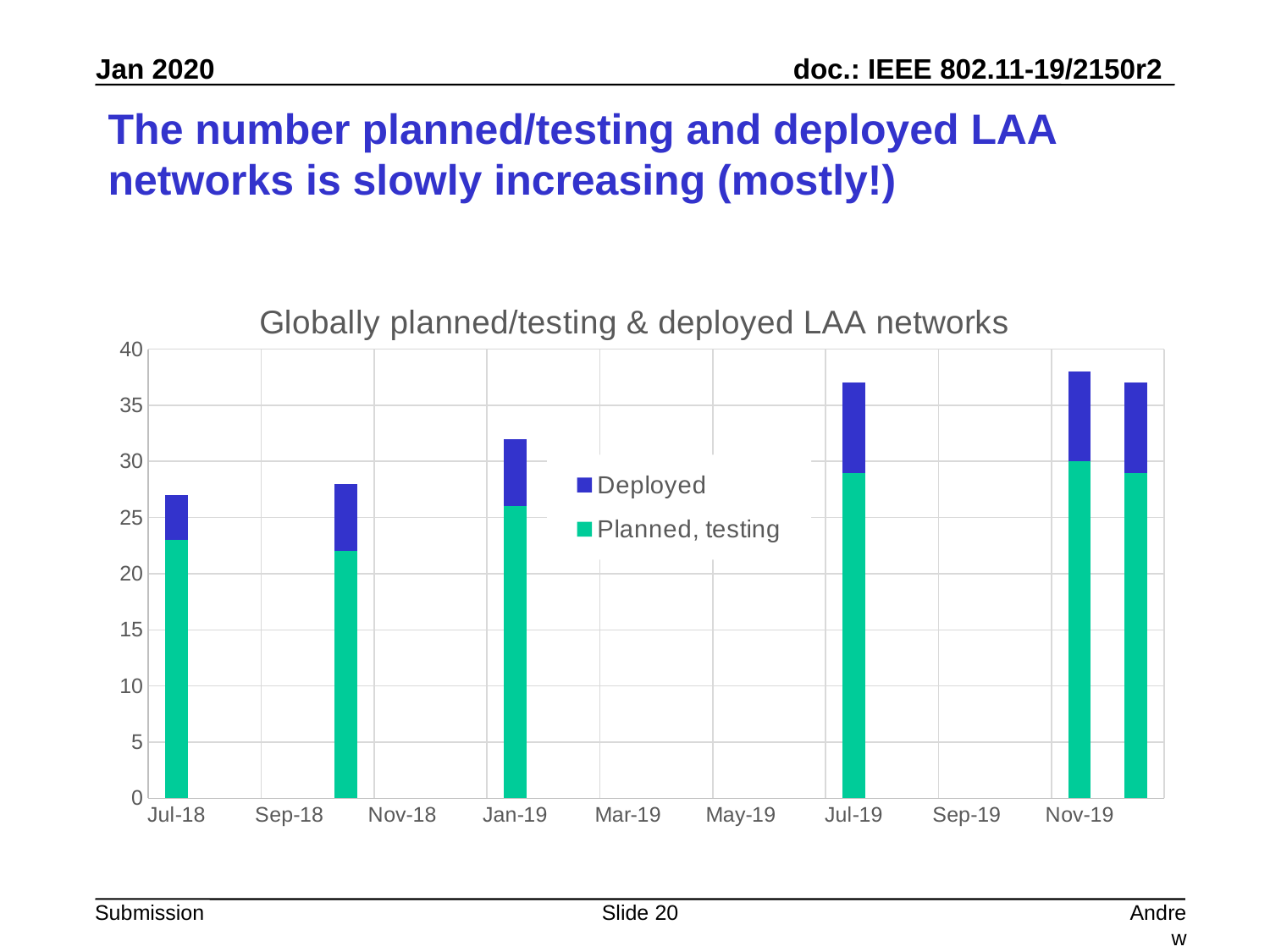
How many bars are plotted in the chart? 6 Is the Planned, testing value for Jan-19 greater or less than 25? greater How many series does the legend list? 2 Which bar is taller in total, Jul-18 or Jul-19? Jul-19 What are the two series named in the legend? Deployed; Planned, testing Do the total bar heights generally rise or fall from Jul-18 to Nov-19? Rise Is the total height of the Jul-19 bar greater or less than 35? greater Is the Planned, testing value for Jul-18 greater or less than 20? greater What is the title of the chart? Globally planned/testing & deployed LAA networks What kind of chart is shown on the slide? Stacked bar chart